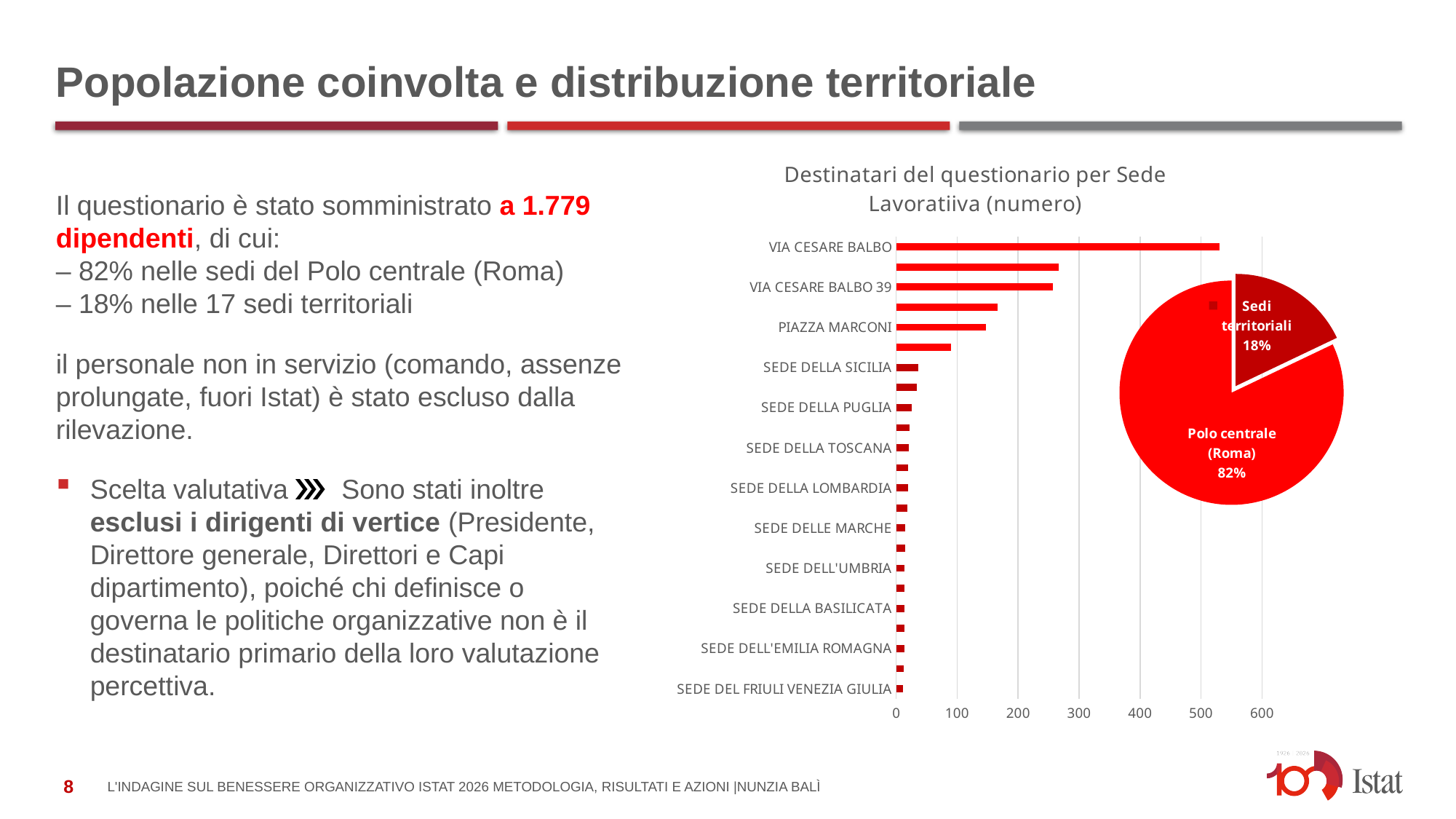
In the bar chart 'Destinatari del questionario per Sede Lavoratiiva (numero)', is the value for PIAZZA MARCONI greater or less than 200? less In the pie chart on the right, what share is shown for Polo centrale (Roma)? 82% What kind of chart is 'Destinatari del questionario per Sede Lavoratiiva (numero)'? bar chart In the bar chart 'Destinatari del questionario per Sede Lavoratiiva (numero)', is the value for SEDE DELLA SICILIA greater or less than 100? less In the bar chart 'Destinatari del questionario per Sede Lavoratiiva (numero)', is the value for VIA CESARE BALBO greater or less than 500? greater In the bar chart 'Destinatari del questionario per Sede Lavoratiiva (numero)', do the bar values increase or decrease going from the top of the chart to the bottom? decrease In the pie chart on the right, what share is shown for Sedi territoriali? 18% In the bar chart 'Destinatari del questionario per Sede Lavoratiiva (numero)', which sede has the highest number of recipients? VIA CESARE BALBO How many slices does the pie chart on the right have? 2 In the bar chart 'Destinatari del questionario per Sede Lavoratiiva (numero)', which is larger: the value for VIA CESARE BALBO or the value for PIAZZA MARCONI? VIA CESARE BALBO What is the title of the bar chart on the slide? Destinatari del questionario per Sede Lavoratiiva (numero)